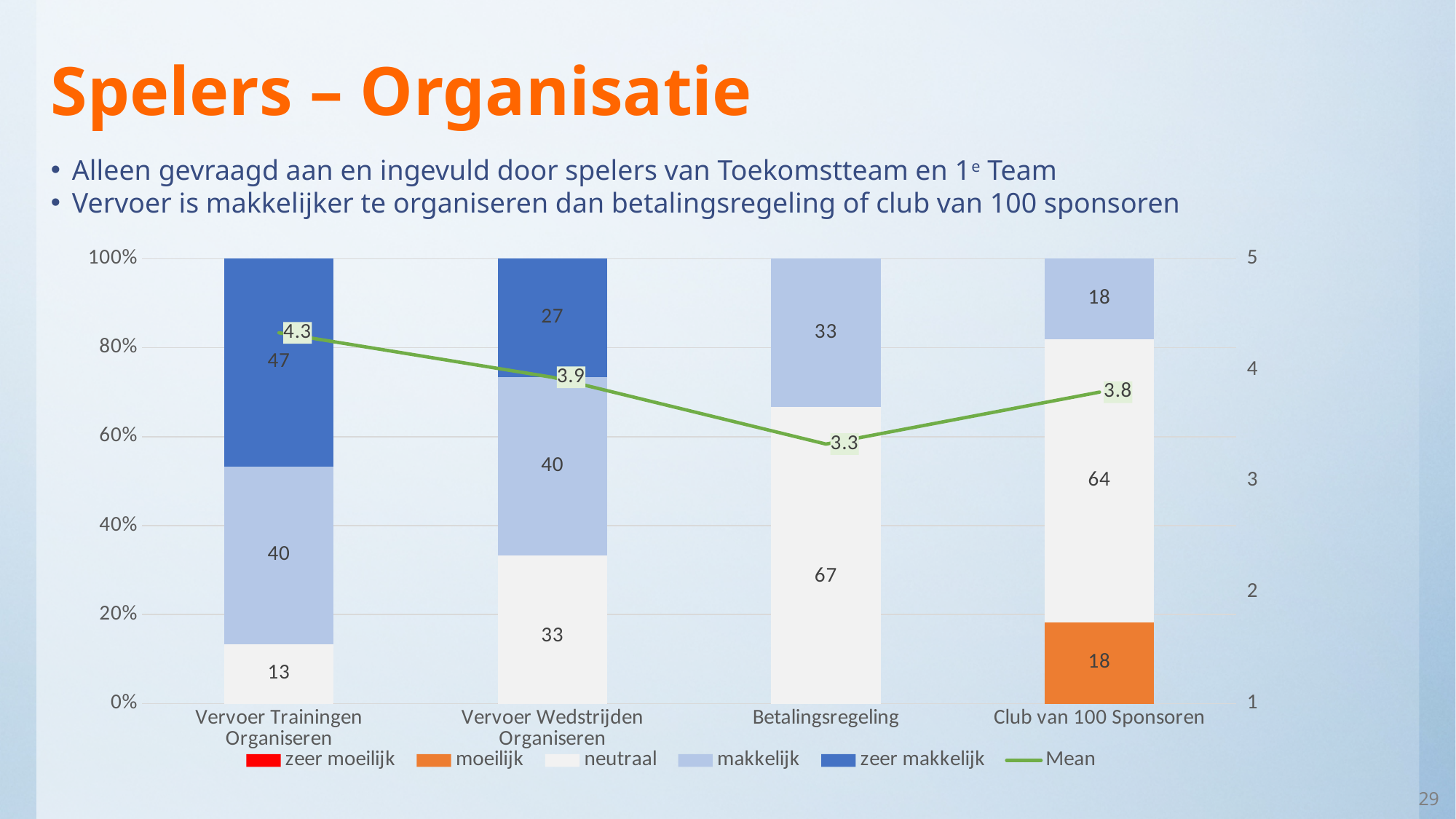
What is the 'neutraal' value for Club van 100 Sponsoren? 64 What is the difference between the Mean values of Vervoer Trainingen Organiseren and Betalingsregeling? 1.0 What kind of chart is this? Stacked bar chart with a line Which category has the highest Mean value? Vervoer Trainingen Organiseren What is the 'zeer makkelijk' value for Vervoer Wedstrijden Organiseren? 27 Which category is the only one with a 'moeilijk' segment? Club van 100 Sponsoren What is the Mean value for Betalingsregeling? 3.3 Which category has the lowest Mean value? Betalingsregeling How many categories are shown on the x axis? 4 How many entries does the legend list? 6 Which is larger: the 'neutraal' value for Betalingsregeling or the 'neutraal' value for Vervoer Wedstrijden Organiseren? Betalingsregeling What is the Mean value for Vervoer Trainingen Organiseren? 4.3